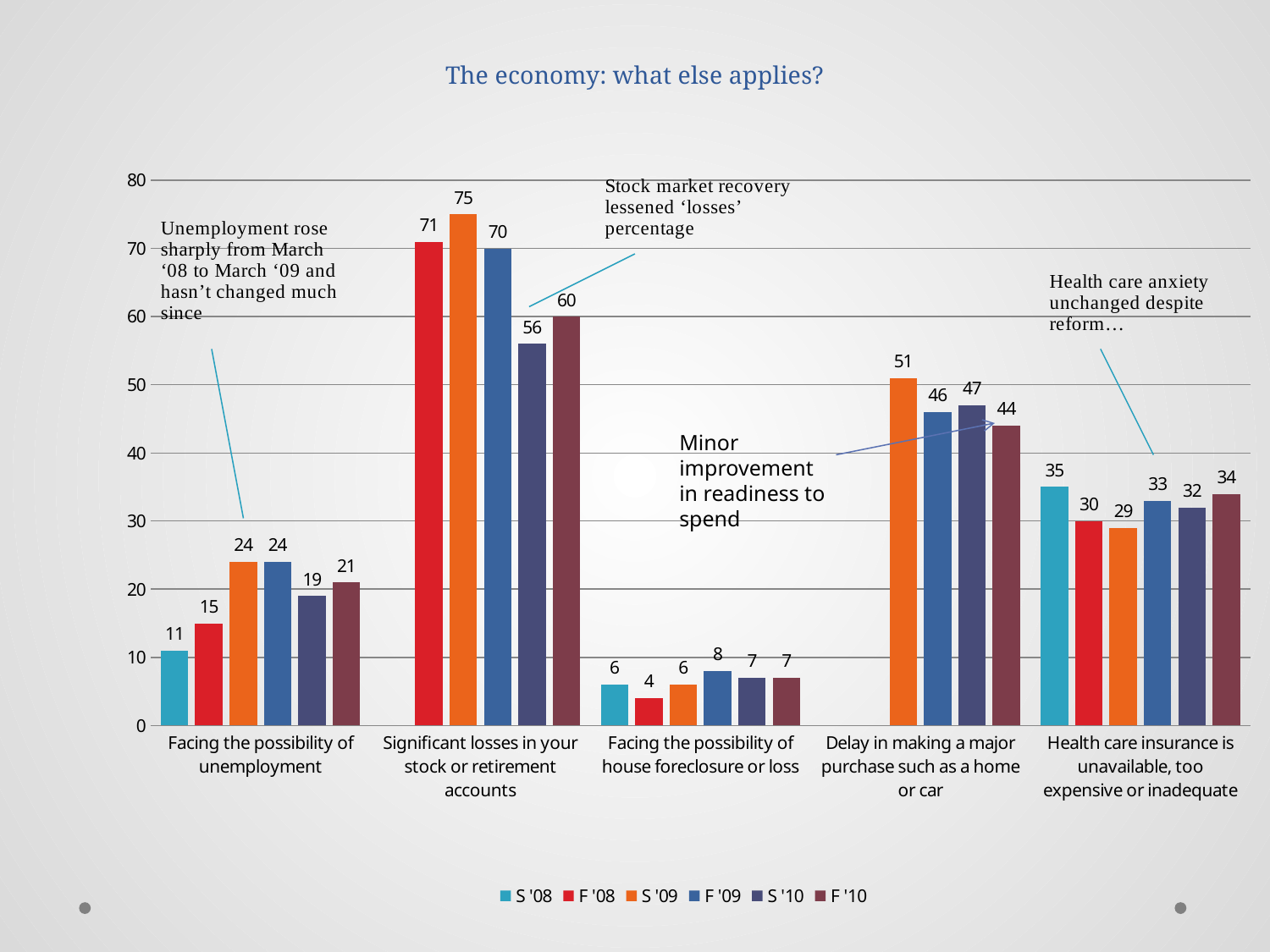
In the 'Facing the possibility of unemployment' category, which is larger: the F '08 value or the S '10 value? S '10 How many categories are shown on the x axis? 5 Which series has the lowest value in the 'Facing the possibility of house foreclosure or loss' category? F '08 What is the difference between the S '08 and F '08 values in the 'Health care insurance is unavailable, too expensive or inadequate' category? 5 What is the value for F '10 in the 'Health care insurance is unavailable, too expensive or inadequate' category? 34 Which series has the highest value in the 'Delay in making a major purchase such as a home or car' category? S '09 What is the title of the slide? The economy: what else applies? What is the value for S '09 in the 'Significant losses in your stock or retirement accounts' category? 75 What kind of chart is shown on the slide? bar chart How many series does the legend list? 6 What is the difference between the S '09 and S '10 values in the 'Significant losses in your stock or retirement accounts' category? 19 What is the value for S '08 in the 'Facing the possibility of unemployment' category? 11